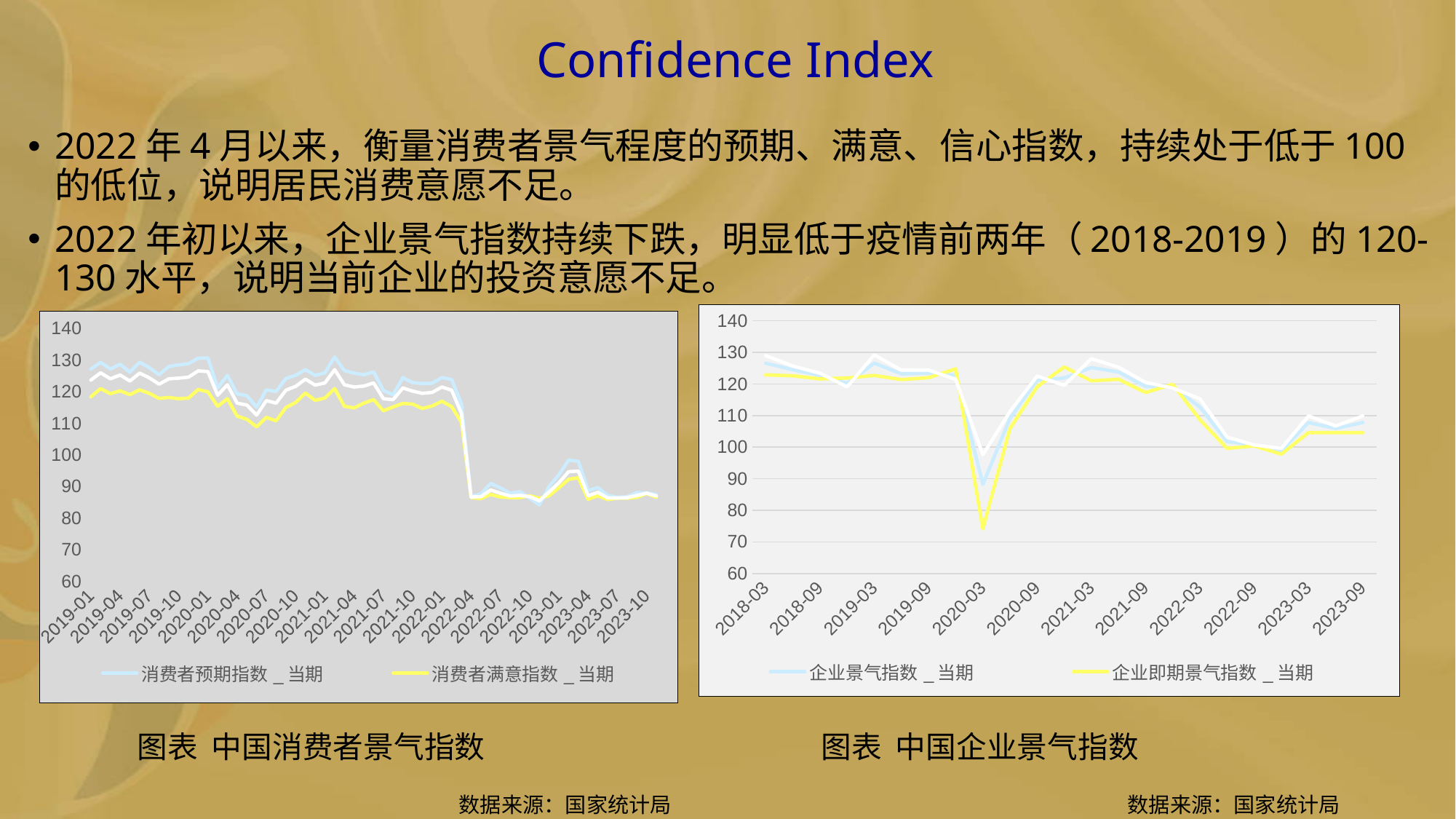
In the right chart (中国企业景气指数), do the values of 企业景气指数_当期 overall rise or fall from 2018-03 to 2023-09? fall In the left chart (中国消费者景气指数), do the values of 消费者预期指数_当期 overall rise or fall from 2019-01 to 2023-10? fall What kind of chart is the left chart titled 图表 中国消费者景气指数? line chart In the right chart (中国企业景气指数), is the value of 企业即期景气指数_当期 at 2020-03 greater or less than 80? less In the left chart (中国消费者景气指数), is the value of 消费者预期指数_当期 at 2023-10 greater or less than 100? less In the left chart (中国消费者景气指数), is the value of 消费者预期指数_当期 at 2019-01 greater or less than 120? greater In the left chart (中国消费者景气指数), how many series does the legend list? 2 What data source is cited below the right chart (中国企业景气指数)? 国家统计局 What kind of chart is the right chart titled 图表 中国企业景气指数? line chart In the right chart (中国企业景气指数), how many series does the legend list? 2